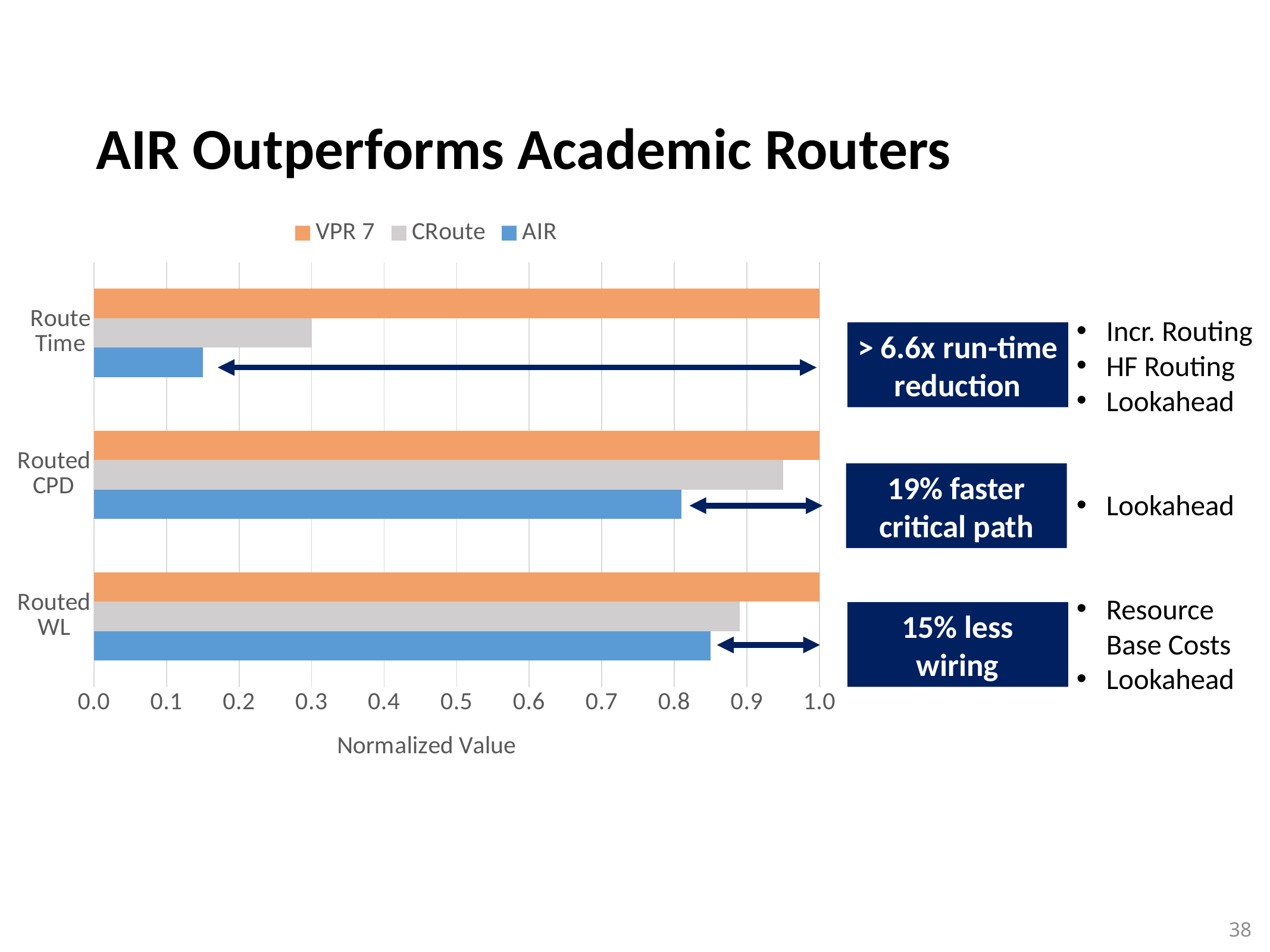
How many categories are shown on the vertical axis of the chart? 3 How many series does the legend list? 3 Which series has the lowest value in the Route Time category? AIR Is the value for AIR in the Routed CPD category greater or less than 0.9? less What kind of chart is shown on the slide? bar chart What is the label of the horizontal axis of the chart? Normalized Value What is the normalized value for VPR 7 in the Route Time category? 1.0 Which series has the highest value in the Routed CPD category? VPR 7 Is the value for AIR in the Route Time category greater or less than 0.2? less In the Routed WL category, which is larger: the value for CRoute or the value for AIR? CRoute Is the value for CRoute in the Routed CPD category greater or less than 0.9? greater What is the normalized value for CRoute in the Route Time category? 0.3